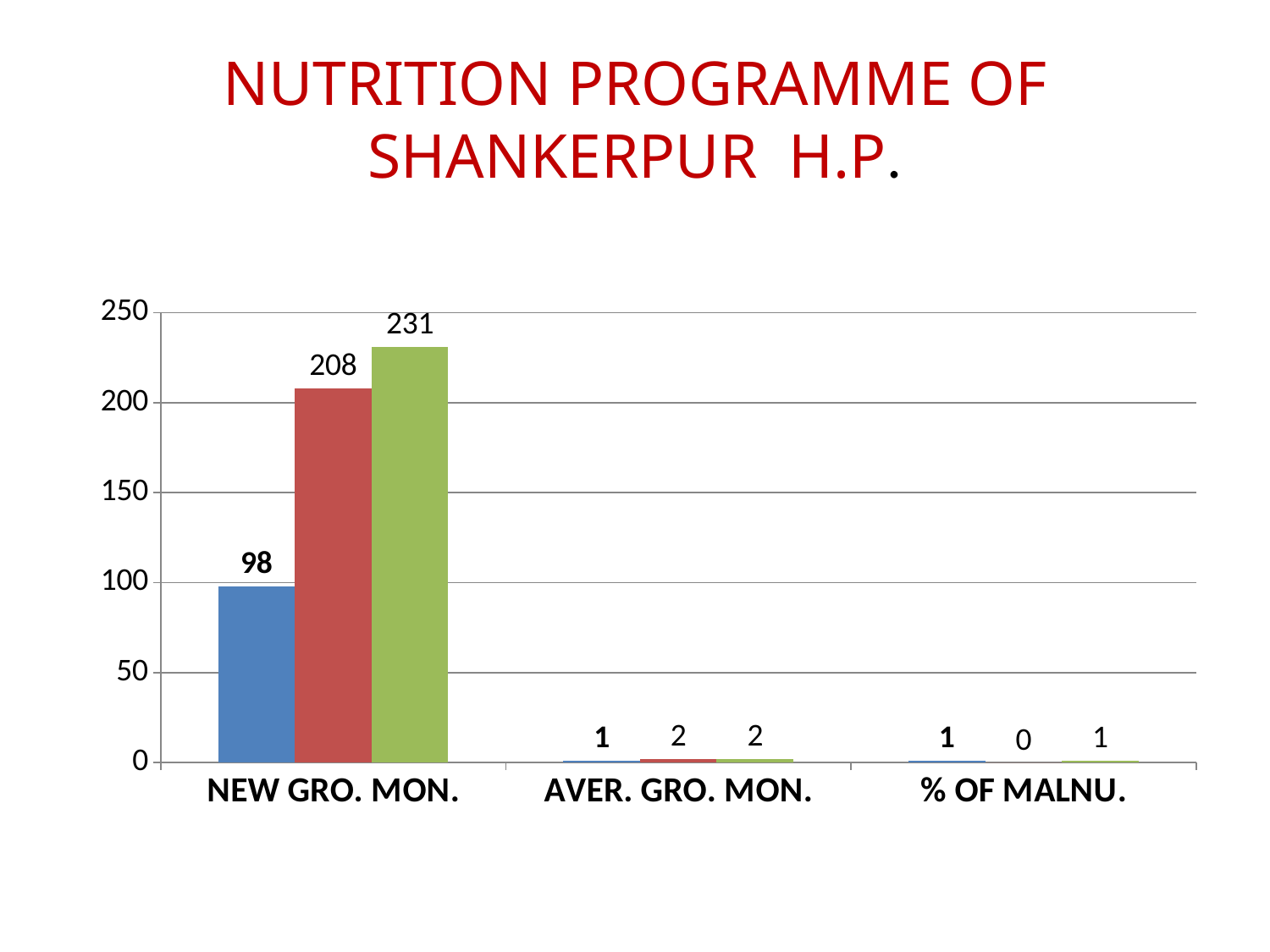
What is the value of the blue bar for NEW GRO. MON.? 98 What is the title of the slide containing the chart? NUTRITION PROGRAMME OF SHANKERPUR H.P. What is the value of the red bar for NEW GRO. MON.? 208 What is the value of the green bar for AVER. GRO. MON.? 2 How many categories are shown on the x axis of the chart? 3 Which is larger for NEW GRO. MON., the red bar or the blue bar? red bar What is the difference between the green bar and the blue bar for NEW GRO. MON.? 133 What is the difference between the green bar and the red bar for NEW GRO. MON.? 23 What kind of chart is shown on the slide? bar chart Which bar in the NEW GRO. MON. category has the highest value? green bar (231) What is the value of the green bar for NEW GRO. MON.? 231 What is the value of the red bar for % OF MALNU.? 0